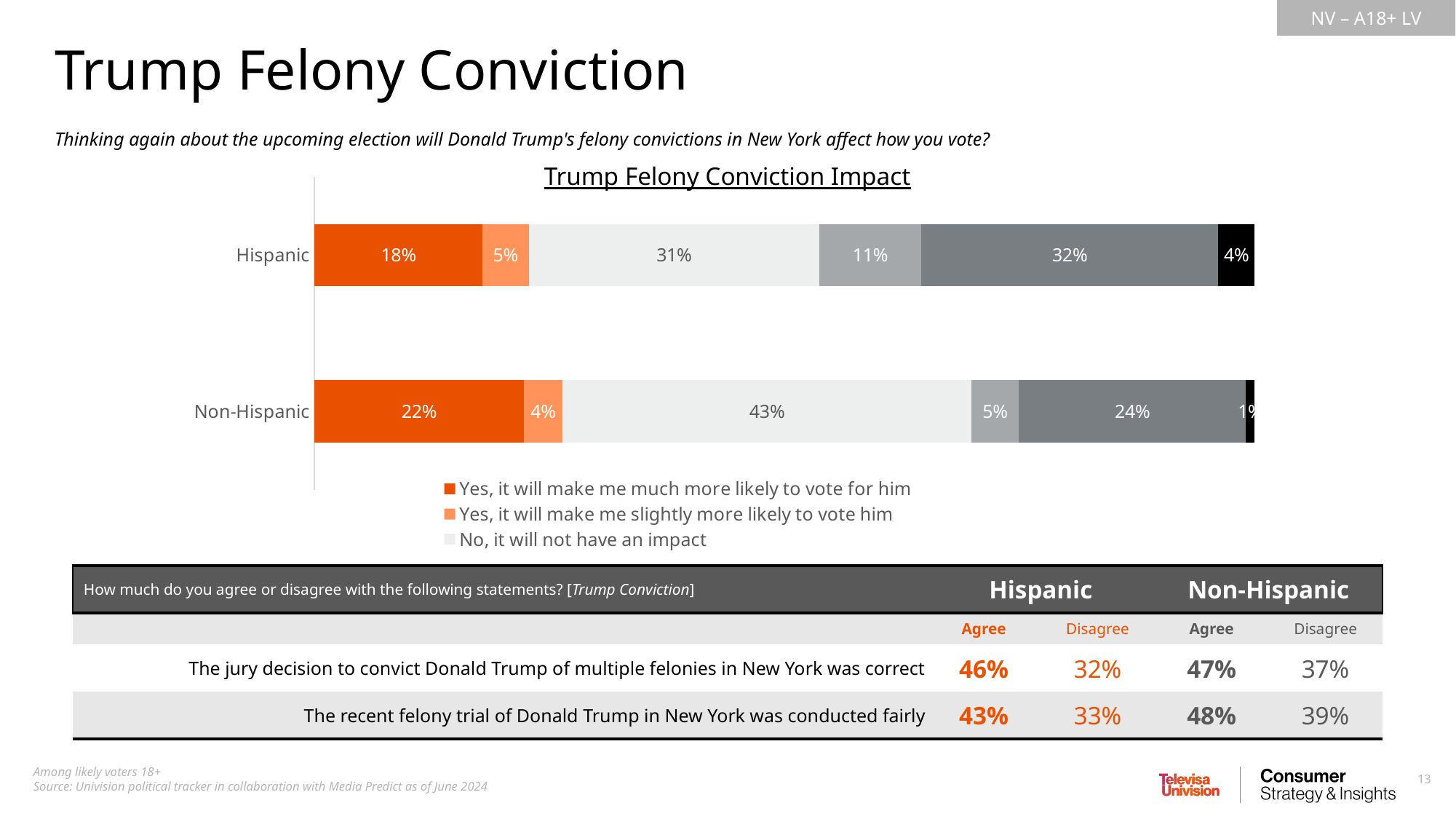
How many groups (bars) are shown in the Trump Felony Conviction Impact chart? 2 In the Trump Felony Conviction Impact chart, what percentage of Hispanic respondents said it will not have an impact? 31% In the Trump Felony Conviction Impact chart, how much higher is the Non-Hispanic 'much more likely to vote for him' share than the Hispanic share? 4 percentage points In the Trump Felony Conviction Impact chart, what is the largest value labeled in the Hispanic bar? 32% In the Trump Felony Conviction Impact chart, which group has the larger share saying the conviction will not have an impact, Hispanic or Non-Hispanic? Non-Hispanic What is the title of the chart on the slide? Trump Felony Conviction Impact In the Trump Felony Conviction Impact chart, what is the difference between the Non-Hispanic and Hispanic shares saying it will not have an impact? 12 percentage points What type of chart is the Trump Felony Conviction Impact chart? Stacked bar chart In the Trump Felony Conviction Impact chart, what percentage of Non-Hispanic respondents said the conviction will make them much more likely to vote for him? 22% In the Trump Felony Conviction Impact chart, what percentage of Hispanic respondents said the conviction will make them much more likely to vote for him? 18% In the Trump Felony Conviction Impact chart, what percentage of Non-Hispanic respondents said it will not have an impact? 43% In the Trump Felony Conviction Impact chart, what percentage of Hispanic respondents said it will make them slightly more likely to vote for him? 5%